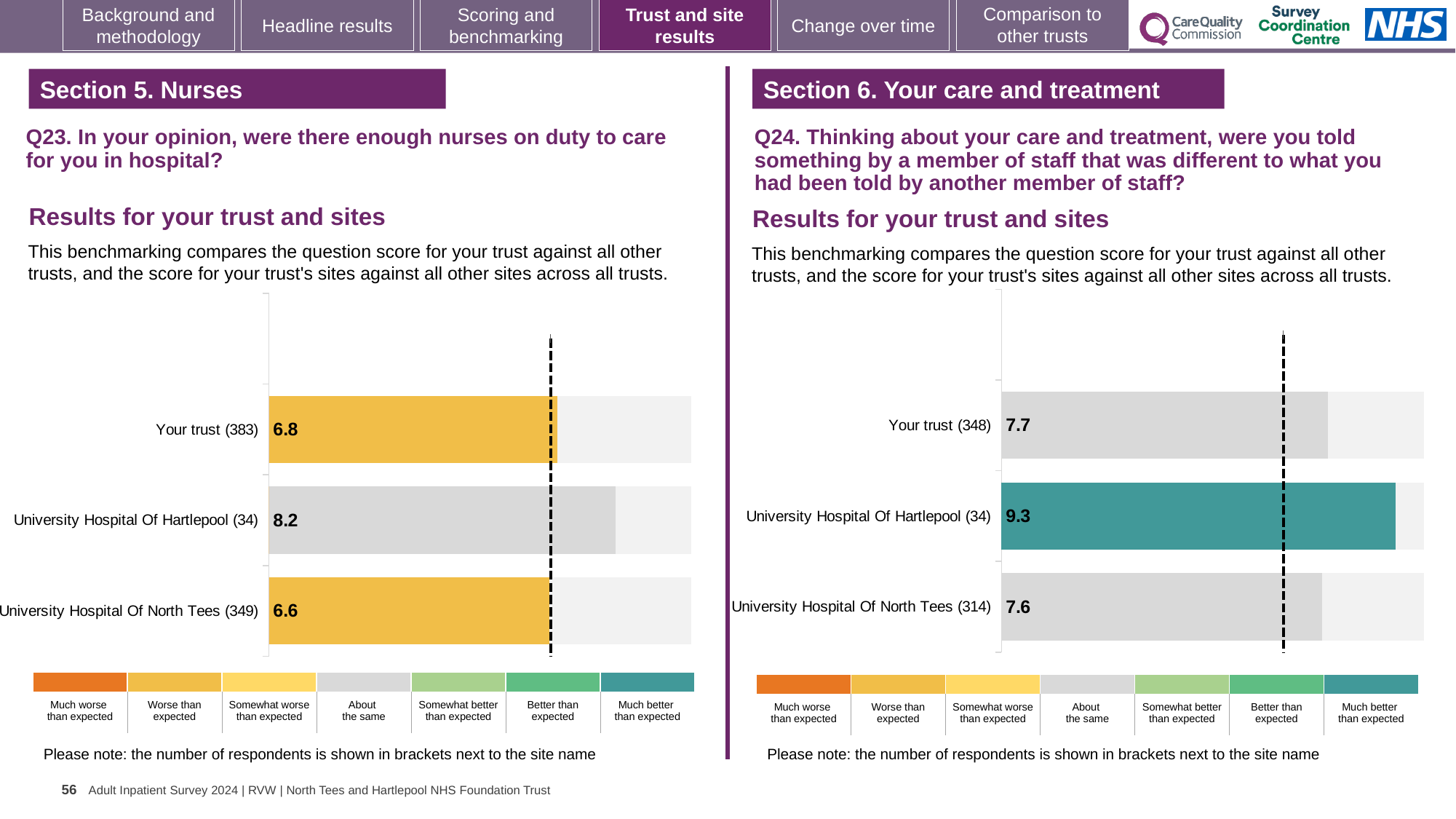
In the Q24 chart on the right, what is the score for University Hospital Of North Tees (314)? 7.6 In the Q23 chart on the left, what is the score for Your trust (383)? 6.8 In the Q24 chart on the right, what is the difference between the scores for University Hospital Of Hartlepool and Your trust? 1.6 In the Q24 chart on the right, which has the larger score: Your trust or University Hospital Of Hartlepool? University Hospital Of Hartlepool In the Q24 chart on the right, how many respondents are shown in brackets for Your trust? 348 In the Q23 chart on the left, how many bars are plotted? 3 In the Q24 chart on the right, what is the score for University Hospital Of Hartlepool (34)? 9.3 In the Q23 chart on the left, which site or trust has the lowest score? University Hospital Of North Tees (349) What type of chart is used for the Q23 results on the left? Bar chart In the Q23 chart on the left, what is the difference between the scores for University Hospital Of Hartlepool and University Hospital Of North Tees? 1.6 In the Q24 chart on the right, which site or trust has the highest score? University Hospital Of Hartlepool (34) In the Q23 chart on the left, what is the score for University Hospital Of Hartlepool (34)? 8.2